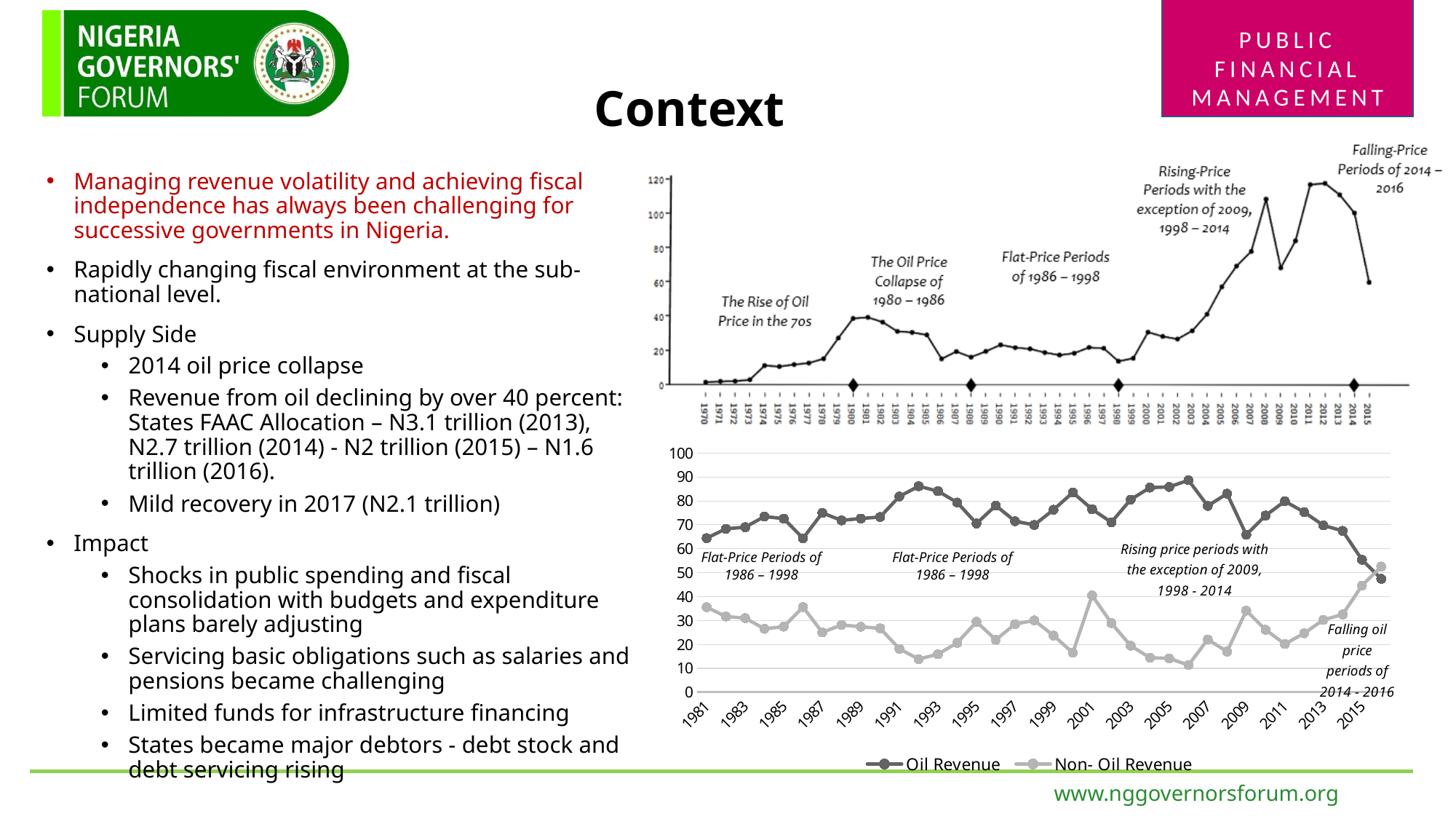
In the top oil price chart, which year has the larger value, 2009 or 2012? 2012 What are the two series named in the legend of the bottom chart? Oil Revenue and Non-Oil Revenue How many series does the legend of the bottom chart list? 2 In the bottom chart, is the Oil Revenue value for 2006 greater or less than 80? greater What kind of chart is the bottom chart with the Oil Revenue and Non-Oil Revenue series? Line chart In the bottom chart, which series has the larger value in 1981, Oil Revenue or Non-Oil Revenue? Oil Revenue In the bottom chart, is the Non-Oil Revenue value for 2006 greater or less than 20? less In the bottom chart, does the Oil Revenue series rise or fall between 2006 and 2016? Fall In the top oil price chart, is the value for 2012 greater or less than 100? greater In the bottom chart, which series has the larger value in 2016, Oil Revenue or Non-Oil Revenue? Non-Oil Revenue In the bottom chart, does the Non-Oil Revenue series rise or fall between 2010 and 2016? Rise